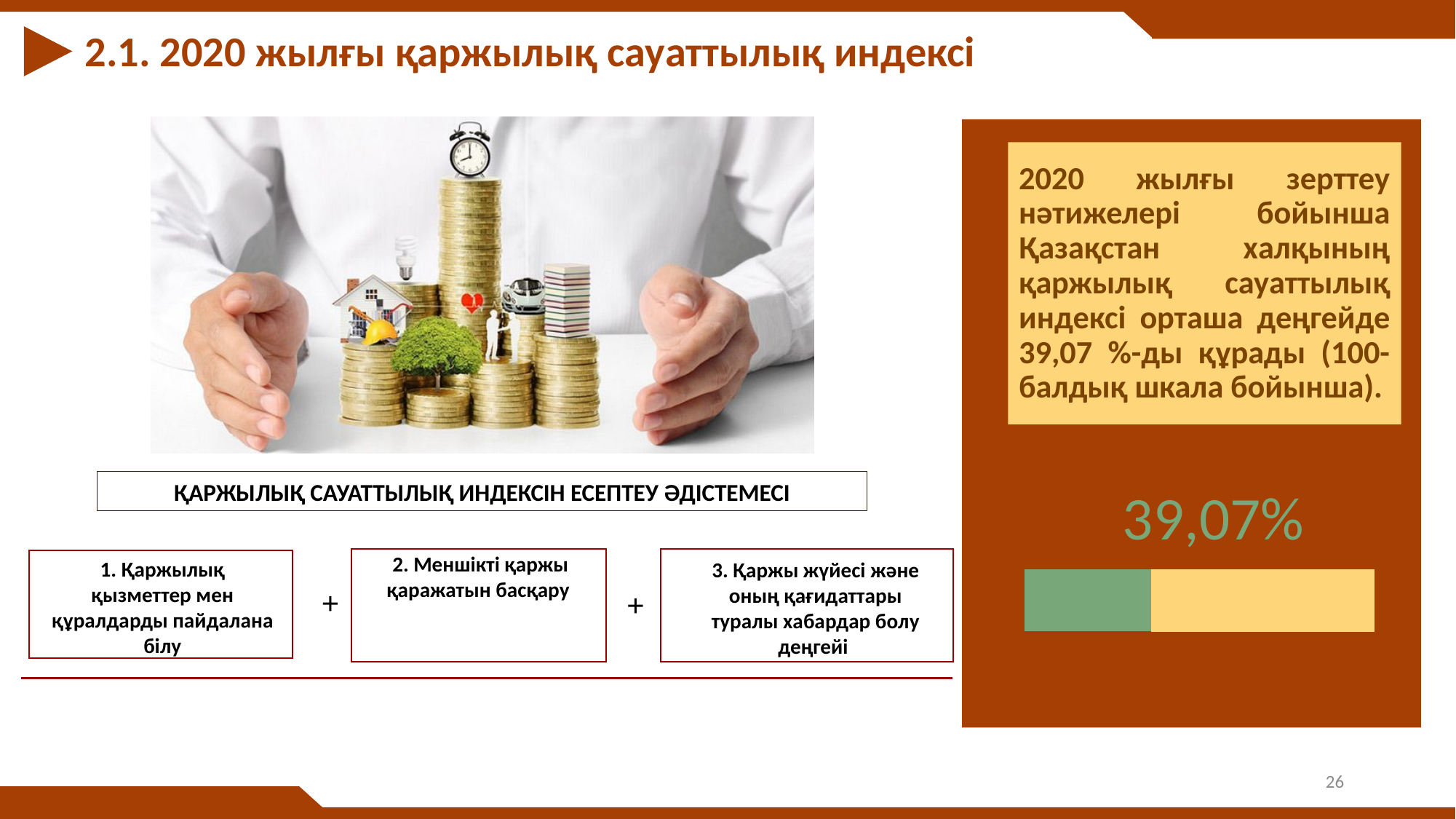
What kind of chart is shown on the right side of the slide? bar chart What value does the bar chart on the right side of the slide display? 39,07% In the bar chart on the right, which segment is larger, the green one or the yellow one? the yellow one Is the bar in the chart on the right side of the slide oriented horizontally or vertically? horizontally How many bars does the chart on the right side of the slide contain? 1 What colour is the filled portion of the bar representing 39,07% in the chart on the right? green Is the value shown by the bar chart on the right greater or less than 50%? less